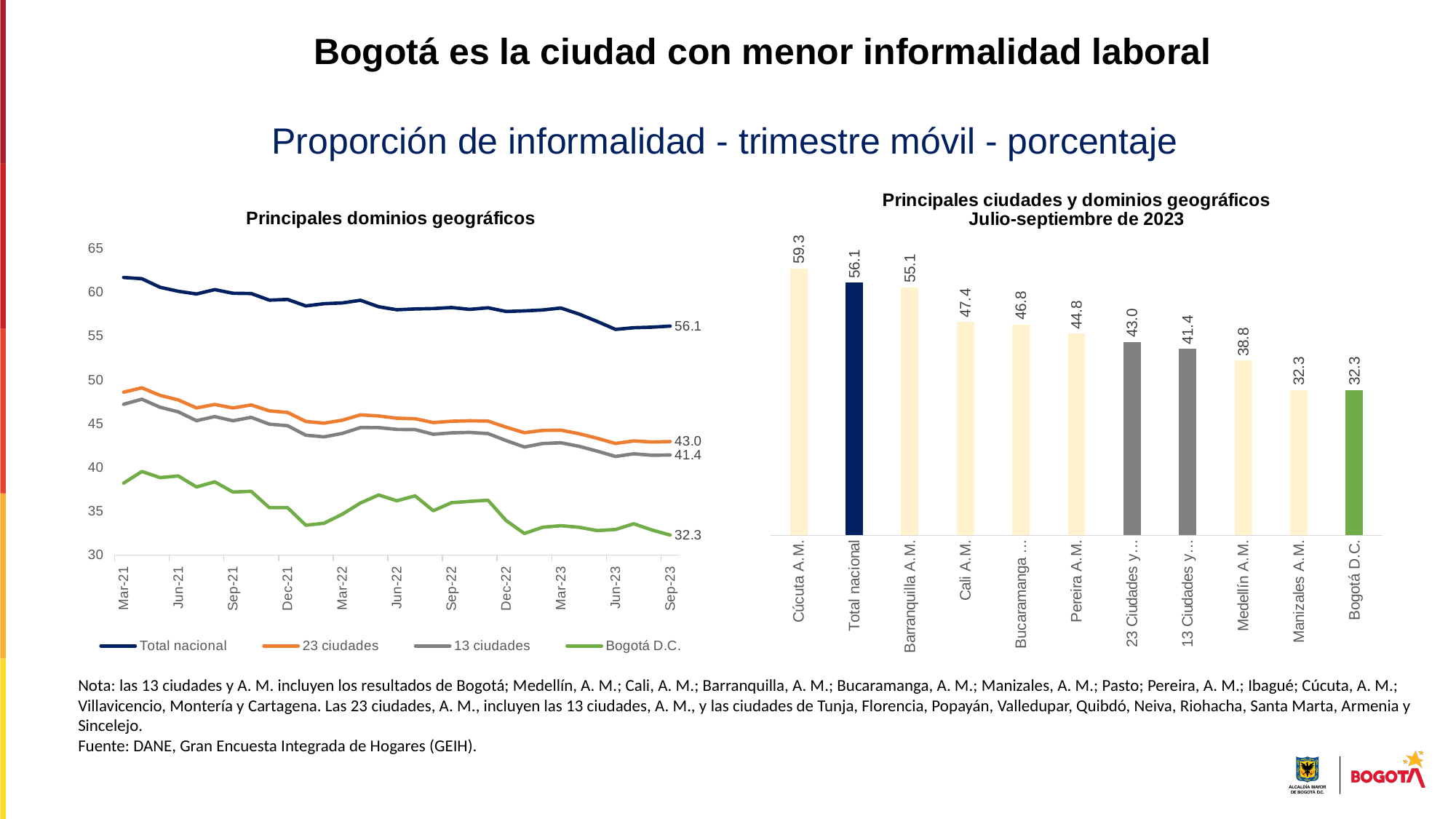
In the chart 'Principales dominios geográficos', does the Total nacional line rise or fall from Mar-21 to Sep-23? fall In the chart 'Principales dominios geográficos', what is the final value shown for Bogotá D.C. at Sep-23? 32.3 In the chart 'Principales dominios geográficos', how many series does the legend list? 4 In the chart 'Principales ciudades y dominios geográficos Julio-septiembre de 2023', what is the difference between Cúcuta A.M. and Bogotá D.C.? 27.0 In the chart 'Principales dominios geográficos', what type of chart is shown? line chart In the chart 'Principales dominios geográficos', what is the final value shown for Total nacional at Sep-23? 56.1 In the chart 'Principales ciudades y dominios geográficos Julio-septiembre de 2023', what type of chart is shown? bar chart In the chart 'Principales ciudades y dominios geográficos Julio-septiembre de 2023', what is the value for Cali A.M.? 47.4 In the chart 'Principales ciudades y dominios geográficos Julio-septiembre de 2023', which is larger, Medellín A.M. or Pereira A.M.? Pereira A.M. In the chart 'Principales dominios geográficos', what is the difference between the Sep-23 values of 23 ciudades and 13 ciudades? 1.6 In the chart 'Principales ciudades y dominios geográficos Julio-septiembre de 2023', how many bars are shown? 11 In the chart 'Principales ciudades y dominios geográficos Julio-septiembre de 2023', which category has the highest value? Cúcuta A.M.